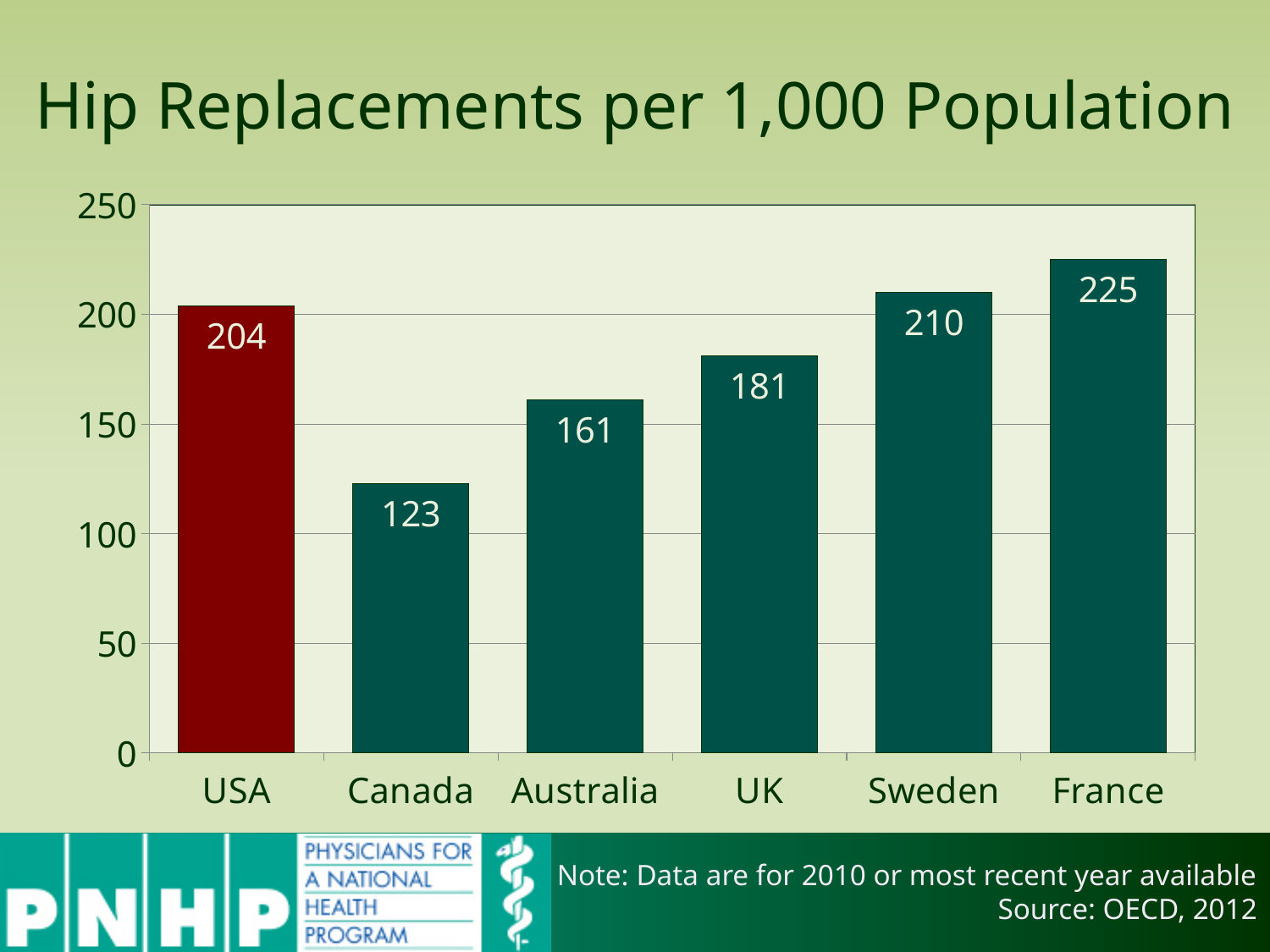
What is the value for the USA? 204 What is the value for Canada? 123 Which country has the lowest value? Canada How many countries are shown in the chart? 6 What is the difference between the values for France and the USA? 21 What is the value for Sweden? 210 Which country has the highest value? France Is the value for Australia greater or less than 150? greater Which is larger, the value for the USA or the value for the UK? USA Which country's bar is coloured differently from the others? USA What kind of chart is shown on the slide? bar chart What is the difference between the values for the UK and Australia? 20